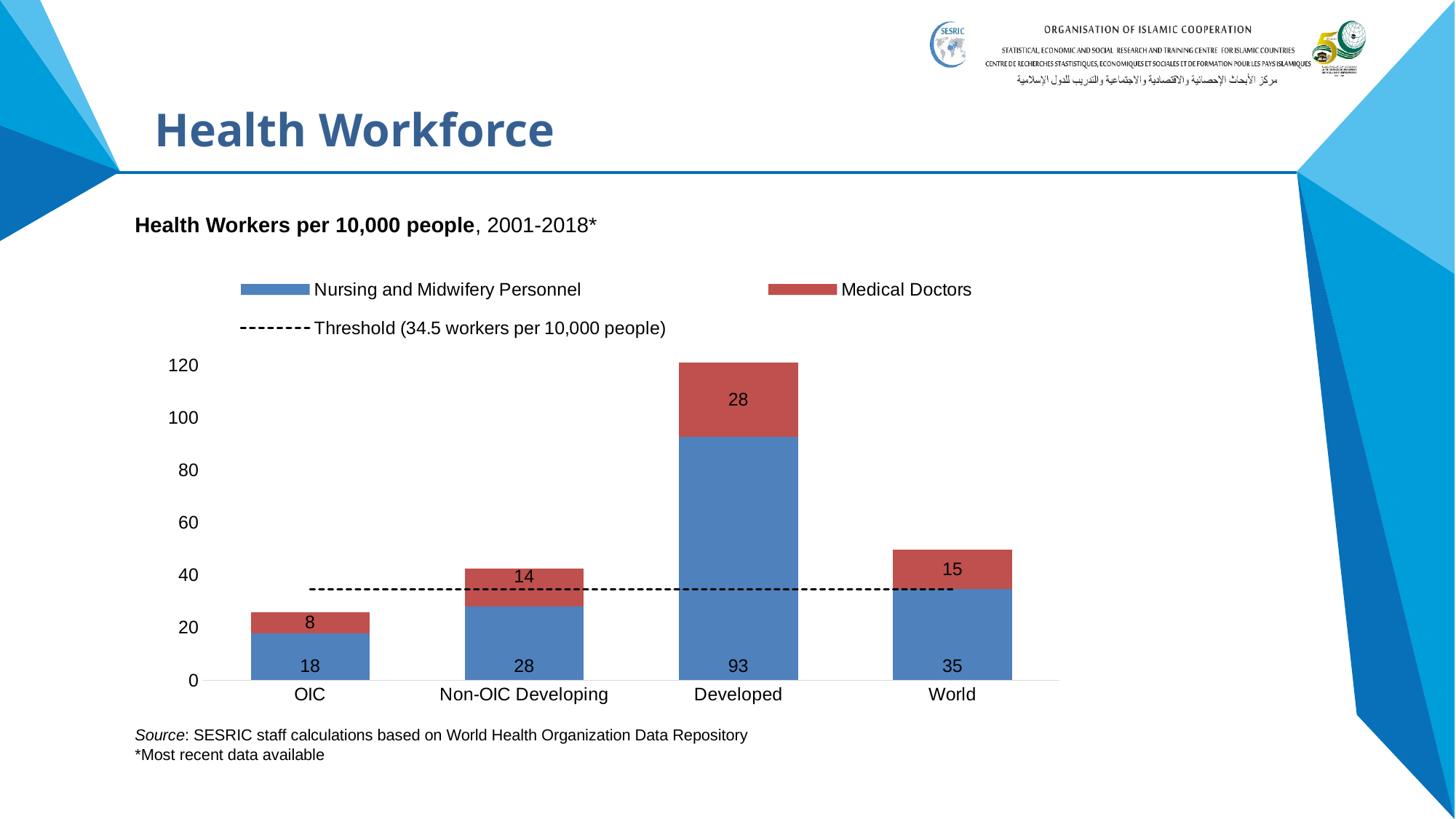
What is the total of the stacked bar for Developed? 121 Which category has the highest value for Nursing and Midwifery Personnel? Developed What threshold value does the dashed line in the legend represent? 34.5 workers per 10,000 people What is the value for Medical Doctors in the World category? 15 What is the difference between the Nursing and Midwifery Personnel values for Developed and OIC? 75 Which is larger: the Medical Doctors value for Non-OIC Developing or for World? World What is the value for Medical Doctors in the Developed category? 28 What is the total of the stacked bar for Non-OIC Developing? 42 What is the value for Nursing and Midwifery Personnel in the OIC category? 18 How many categories are shown on the x axis? 4 What kind of chart is shown on the slide? Stacked bar chart Which category has the lowest value for Medical Doctors? OIC